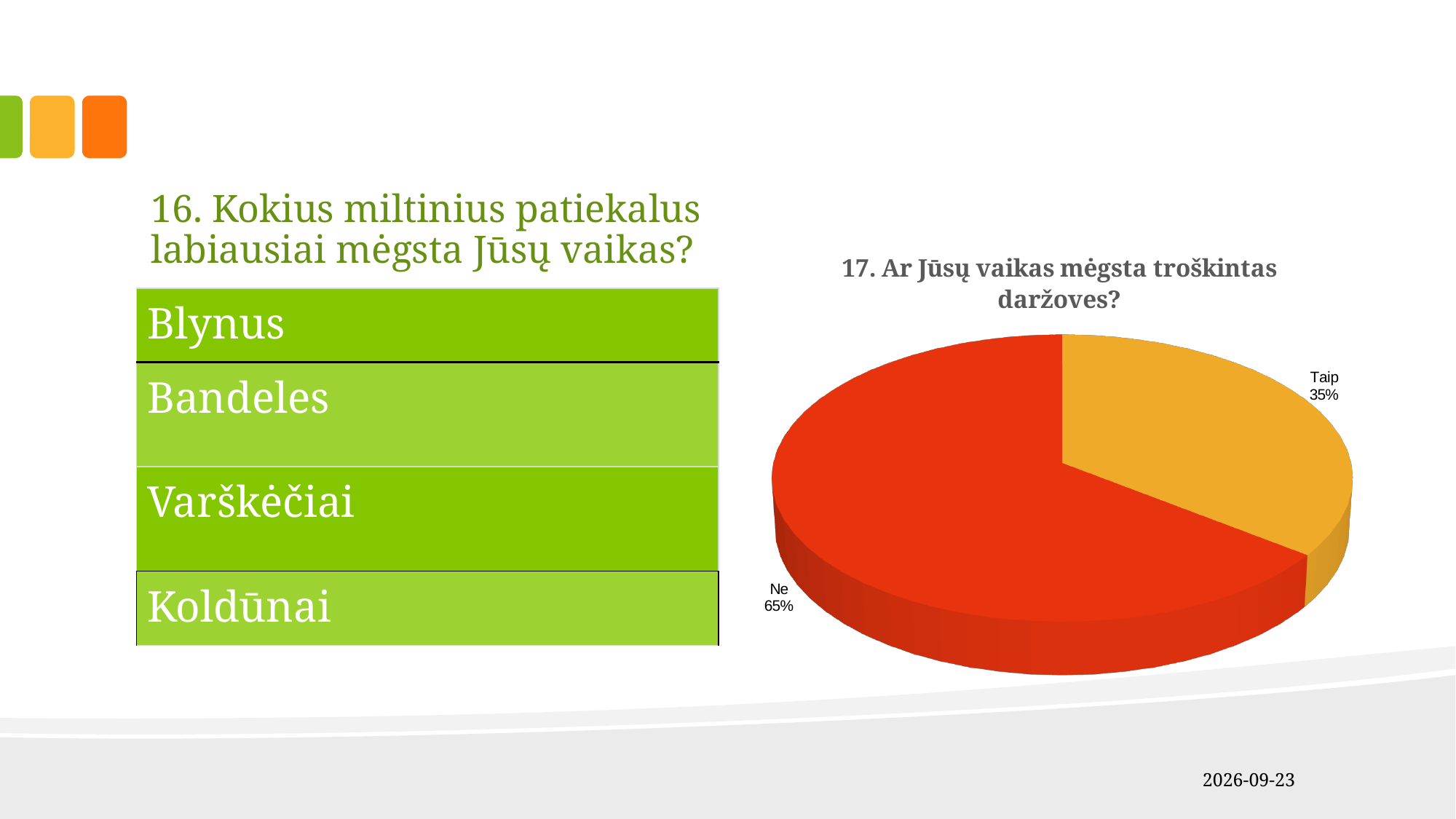
What is the title of the pie chart? 17. Ar Jūsų vaikas mėgsta troškintas daržoves? What kind of chart is shown on the slide? pie chart Which slice of the pie chart is the largest? Ne What share of the pie does the "Taip" slice represent? 35% How many slices does the pie chart have? 2 Which slice of the pie chart is the smallest? Taip What share of the pie does the "Ne" slice represent? 65% Which is larger, the "Taip" slice or the "Ne" slice? Ne What colour is the "Ne" slice of the pie chart? red What is the difference in percentage points between the "Ne" and "Taip" slices? 30